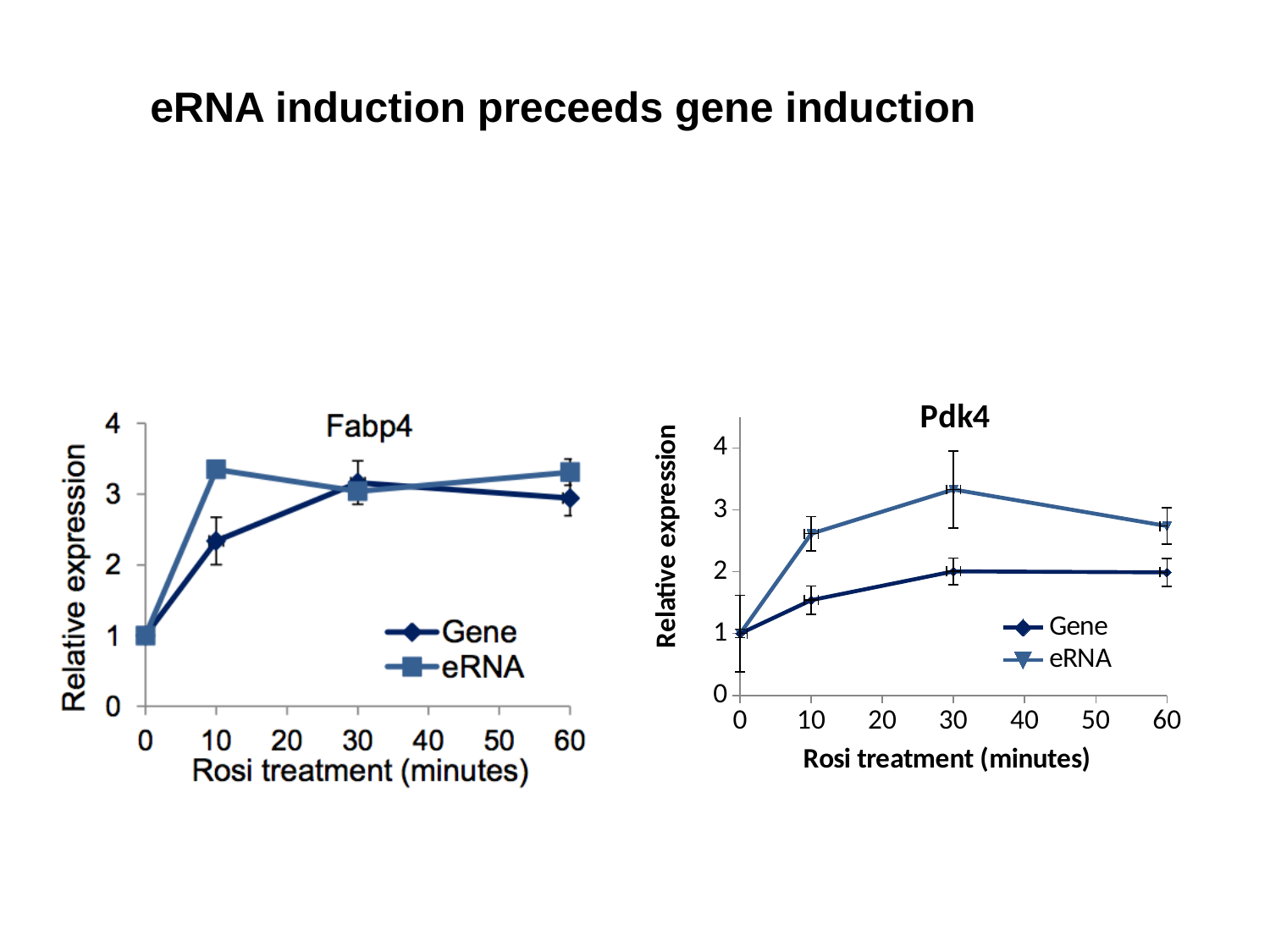
What kind of chart is the Fabp4 chart on the left? line chart In the Pdk4 chart, how many series does the legend list? 2 In the Pdk4 chart, what is the relative expression of Gene at 30 minutes? 2 In the Pdk4 chart, which series has the higher value at 60 minutes, Gene or eRNA? eRNA In the Fabp4 chart, is the Gene value at 10 minutes greater or less than 3? less In the Pdk4 chart, how many time points are plotted for each series? 4 In the Fabp4 chart, which series has the higher value at 10 minutes, Gene or eRNA? eRNA In the Pdk4 chart, at which time point does the eRNA series reach its highest value? 30 minutes In the Fabp4 chart, what is the relative expression of Gene at 0 minutes? 1 In the Pdk4 chart, is the eRNA value at 30 minutes greater or less than 3? greater What is the x-axis title of the Pdk4 chart? Rosi treatment (minutes) In the Fabp4 chart, is the eRNA value at 10 minutes greater or less than 3? greater